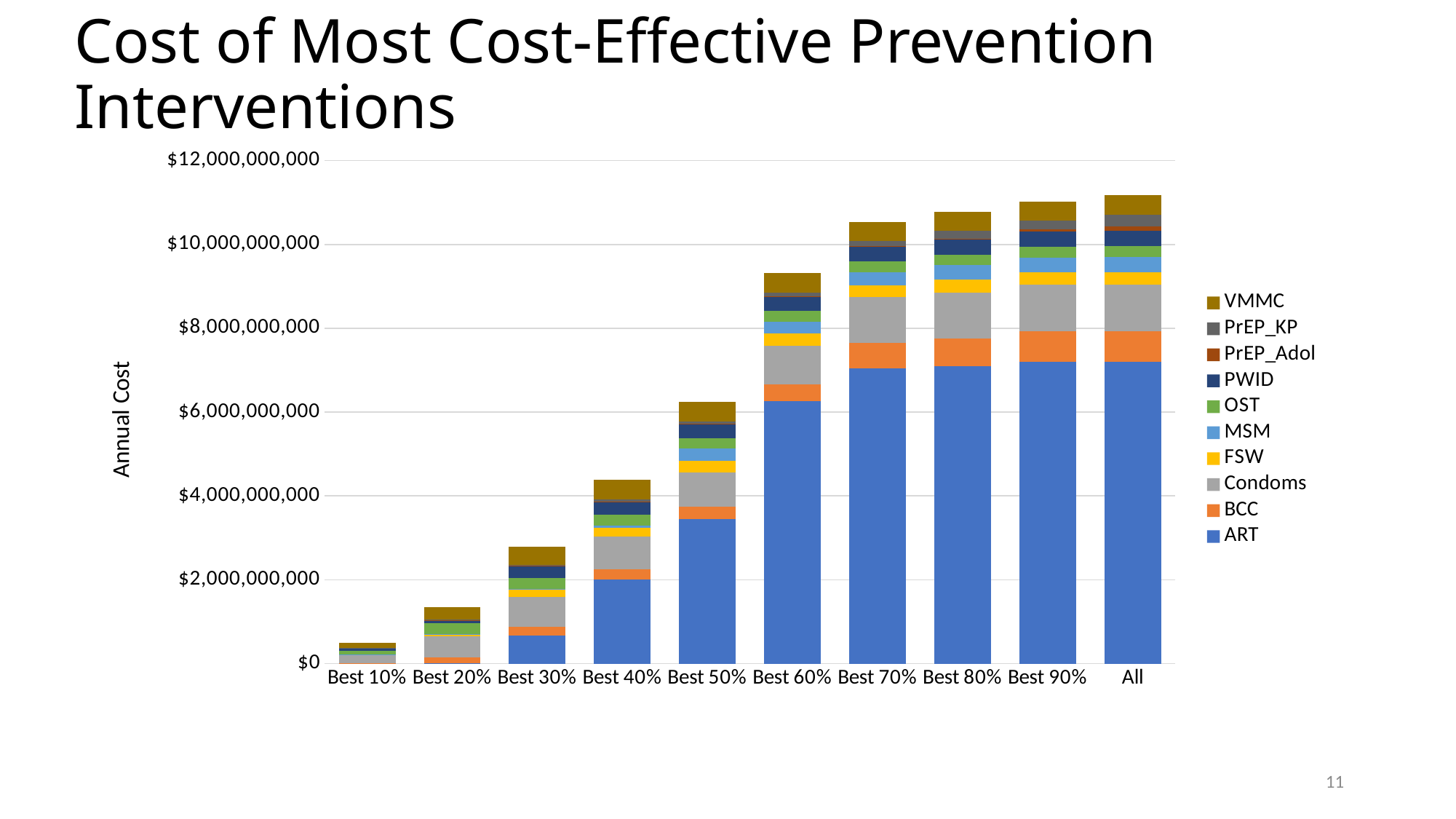
What is the label of the vertical axis? Annual Cost How many categories are shown along the x axis? 10 Is the total annual cost for All greater or less than $12,000,000,000? less Which has the larger total annual cost, Best 50% or Best 60%? Best 60% Which series forms the bottom segment of each stacked bar? ART Is the total annual cost for Best 60% greater or less than $8,000,000,000? greater Which category has the lowest total annual cost? Best 10% Do the total annual costs rise or fall from Best 10% to All along the x axis? Rise Which category has the highest total annual cost? All How many series does the legend list? 10 What kind of chart is shown on the slide? Stacked bar chart Is the total annual cost for Best 20% greater or less than $2,000,000,000? less